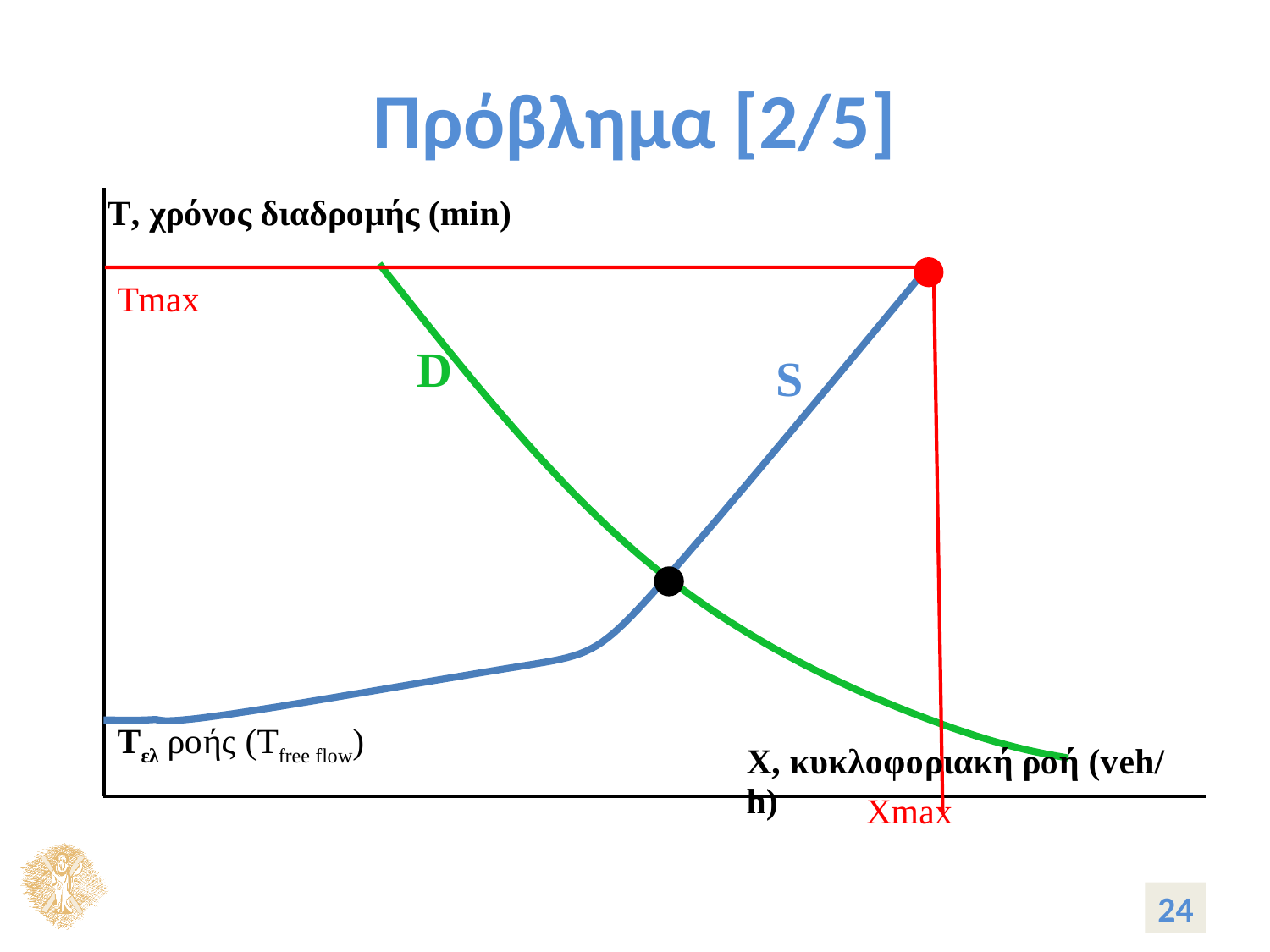
Does the curve labelled D rise or fall as X increases? Falls What label is written next to the horizontal red line at the top of the chart? Tmax What colour is the curve labelled S? Blue How many curves are plotted on the chart? 2 What kind of chart is shown on the slide? Line chart What label is written below the vertical red line on the horizontal axis? Xmax Does the curve labelled S rise or fall as X increases? Rises